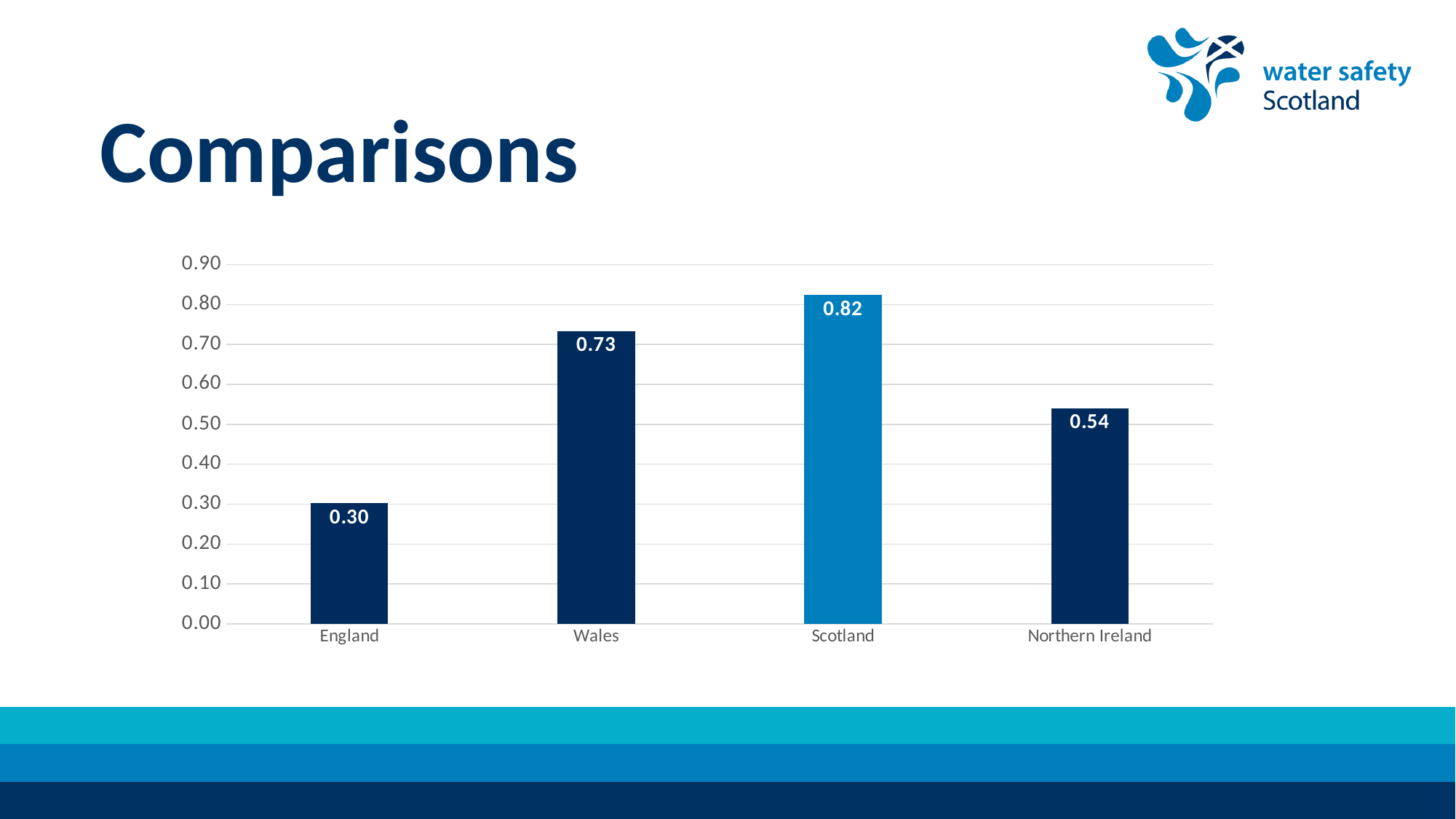
What kind of chart is shown on the slide? Bar chart Which is larger, the value for Wales or the value for Northern Ireland? Wales What is the value for Wales? 0.73 Which category has the highest value? Scotland What is the value for Scotland? 0.82 What is the value for Northern Ireland? 0.54 How many categories are shown on the chart? 4 What is the value for England? 0.30 Which bar is shown in a lighter blue colour than the others? Scotland What is the difference between the values for Scotland and England? 0.52 Which category has the lowest value? England What is the difference between the values for Wales and Northern Ireland? 0.19